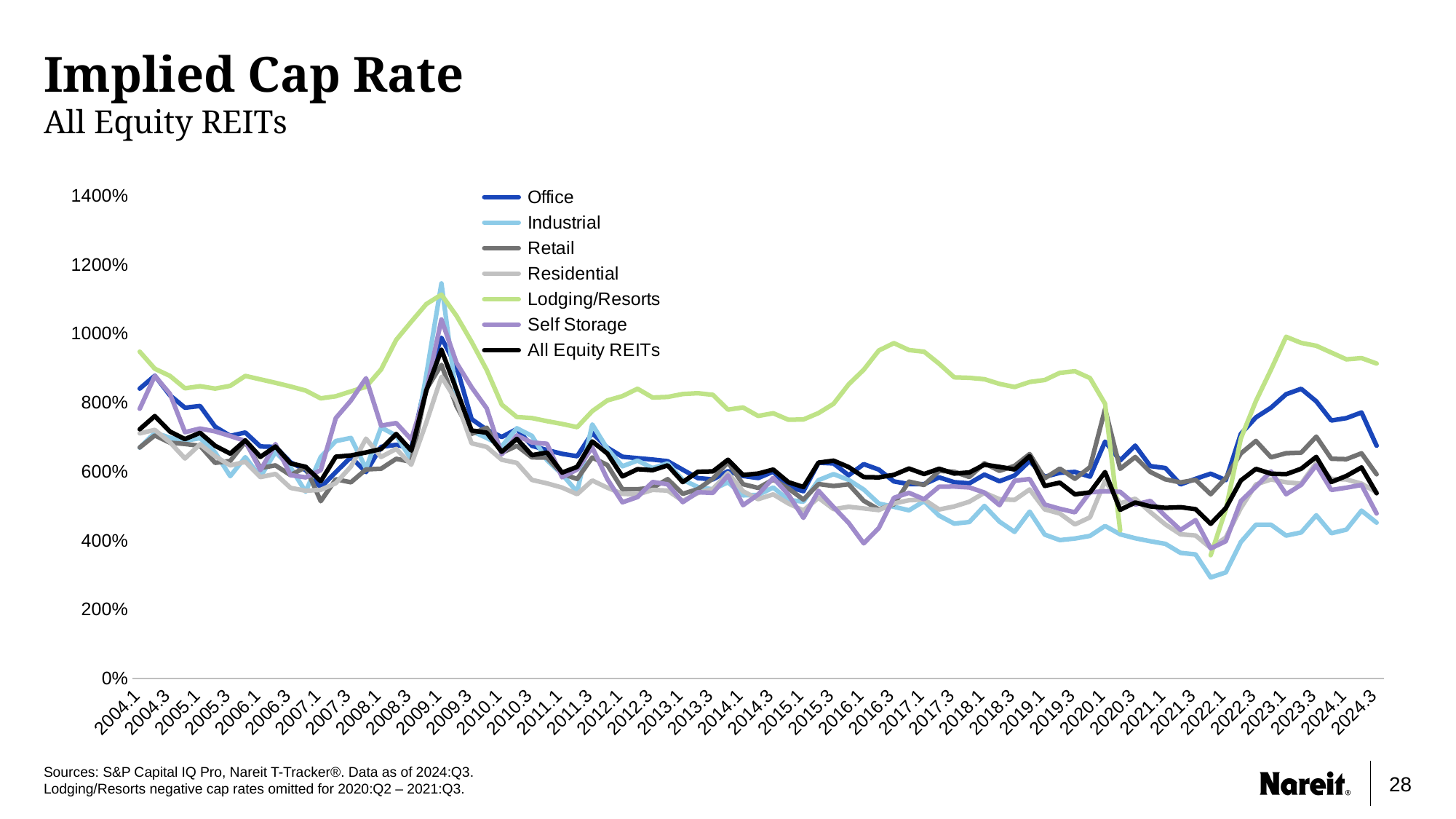
Does the Lodging/Resorts line rise or fall from 2023.1 to 2024.3? fall Is the value for Industrial at 2022.1 greater or less than 400%? less Is the value for All Equity REITs at 2024.3 greater or less than 600%? less Which series has the highest value at 2024.3? Lodging/Resorts Which series is drawn with the black line? All Equity REITs What is the title of the chart? Implied Cap Rate Is the value for Lodging/Resorts at 2009.1 greater or less than 1000%? greater How many series does the legend list? 7 At 2024.3, which is larger: Office or Industrial? Office What kind of chart is shown on the slide? line chart Which series has the lowest value at 2021.3? Industrial